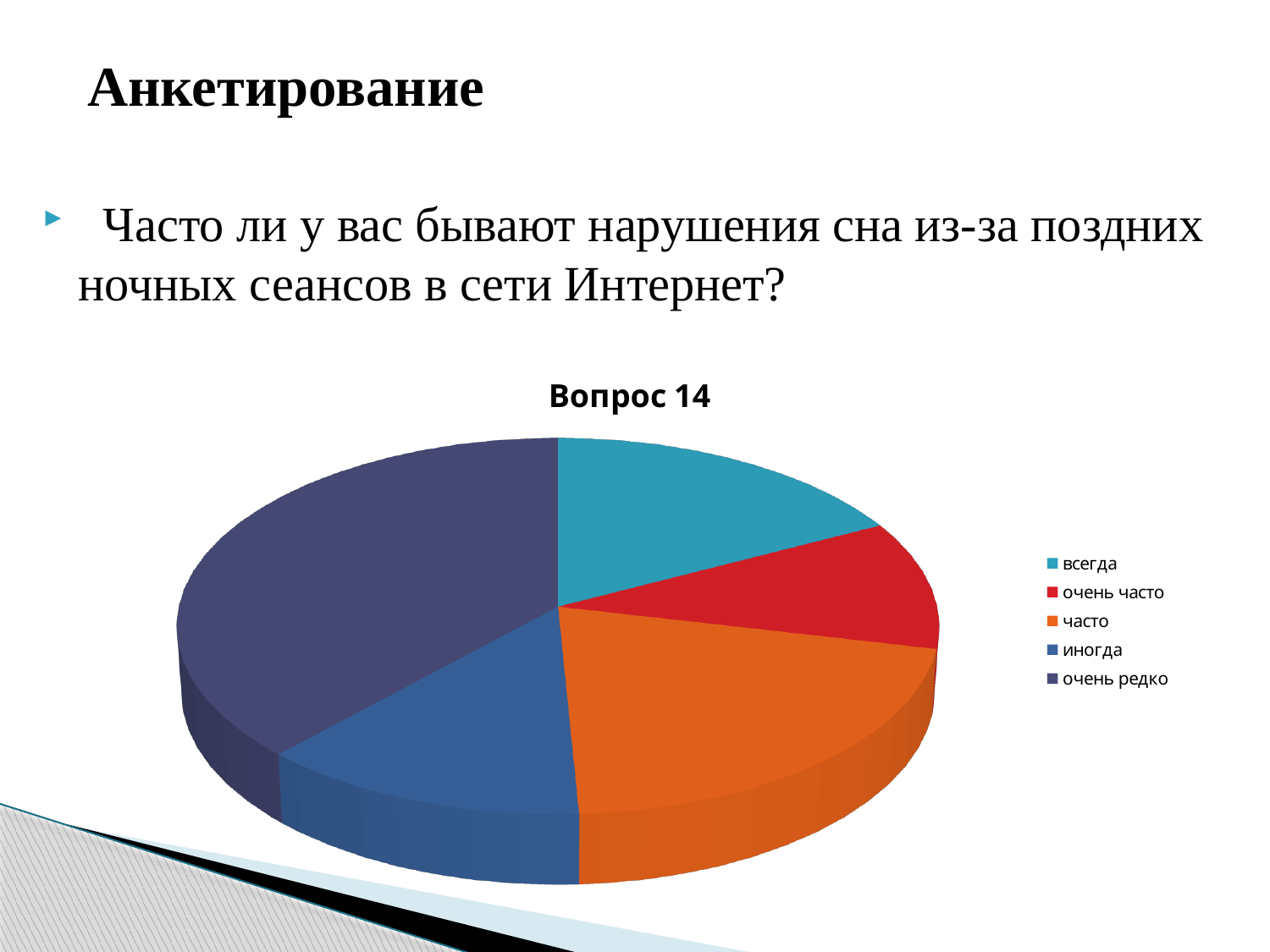
Which category has the smallest slice of the pie? очень часто What kind of chart is shown on the slide? pie chart Which category has the largest slice of the pie? очень редко How many entries does the legend list? 5 Which slice is larger, очень редко or всегда? очень редко Which slice is larger, очень редко or иногда? очень редко How many slices does the pie chart have? 5 What colour is the slice for очень часто? red What is the title of the chart? Вопрос 14 Which slice is larger, часто or очень часто? часто